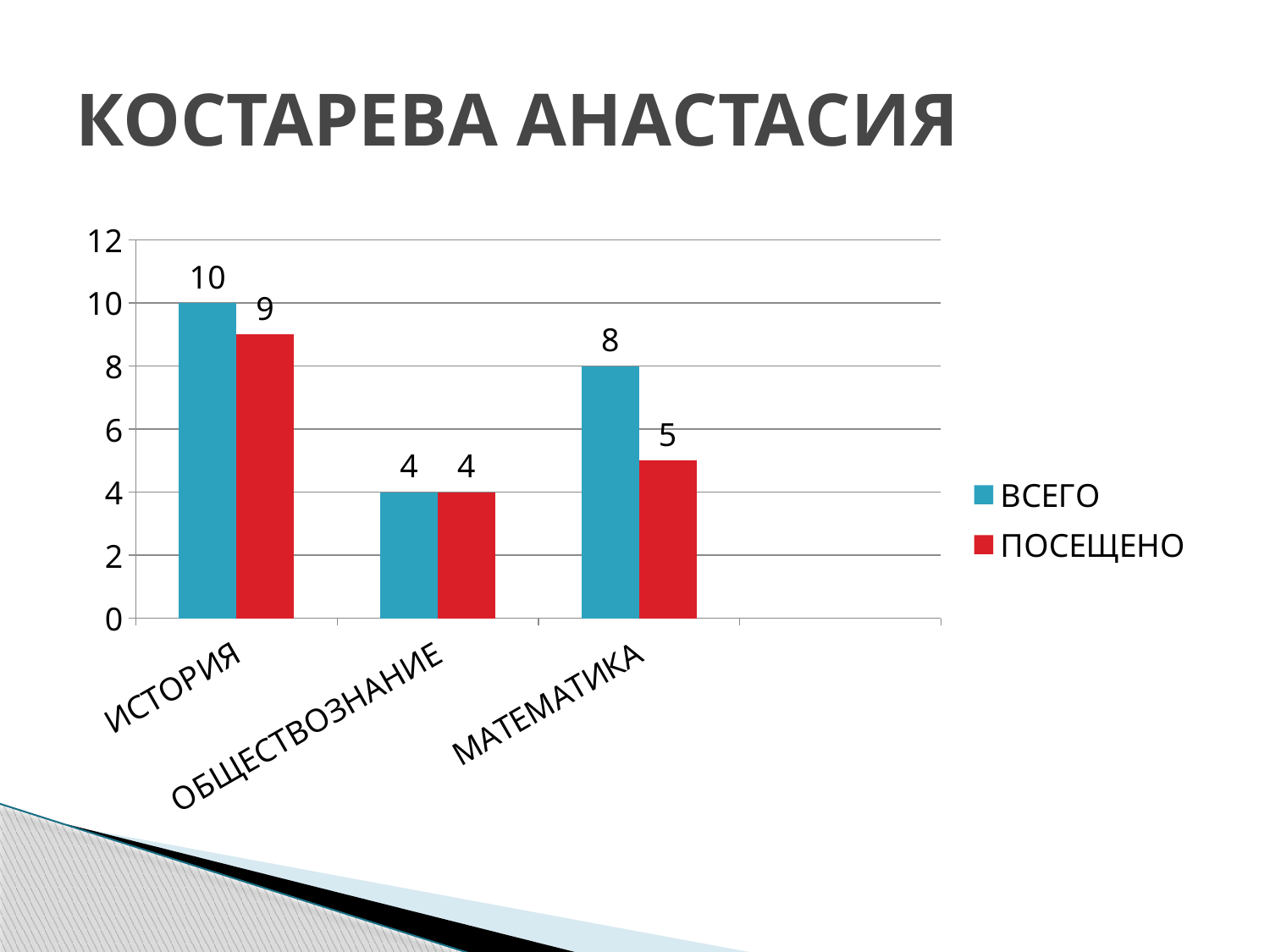
Which is larger: the ПОСЕЩЕНО value for ИСТОРИЯ or the ПОСЕЩЕНО value for МАТЕМАТИКА? ИСТОРИЯ What is the difference between the ВСЕГО values for ИСТОРИЯ and МАТЕМАТИКА? 2 What is the ВСЕГО value for ИСТОРИЯ? 10 How many categories are shown on the x axis? 3 Which colour represents the ПОСЕЩЕНО series? Red What is the difference between ВСЕГО and ПОСЕЩЕНО for МАТЕМАТИКА? 3 How many series does the legend list? 2 What kind of chart is shown on the slide? Bar chart Which category has the highest ВСЕГО value? ИСТОРИЯ What is the ПОСЕЩЕНО value for ОБЩЕСТВОЗНАНИЕ? 4 Which category has the lowest ПОСЕЩЕНО value? ОБЩЕСТВОЗНАНИЕ What is the ПОСЕЩЕНО value for МАТЕМАТИКА? 5